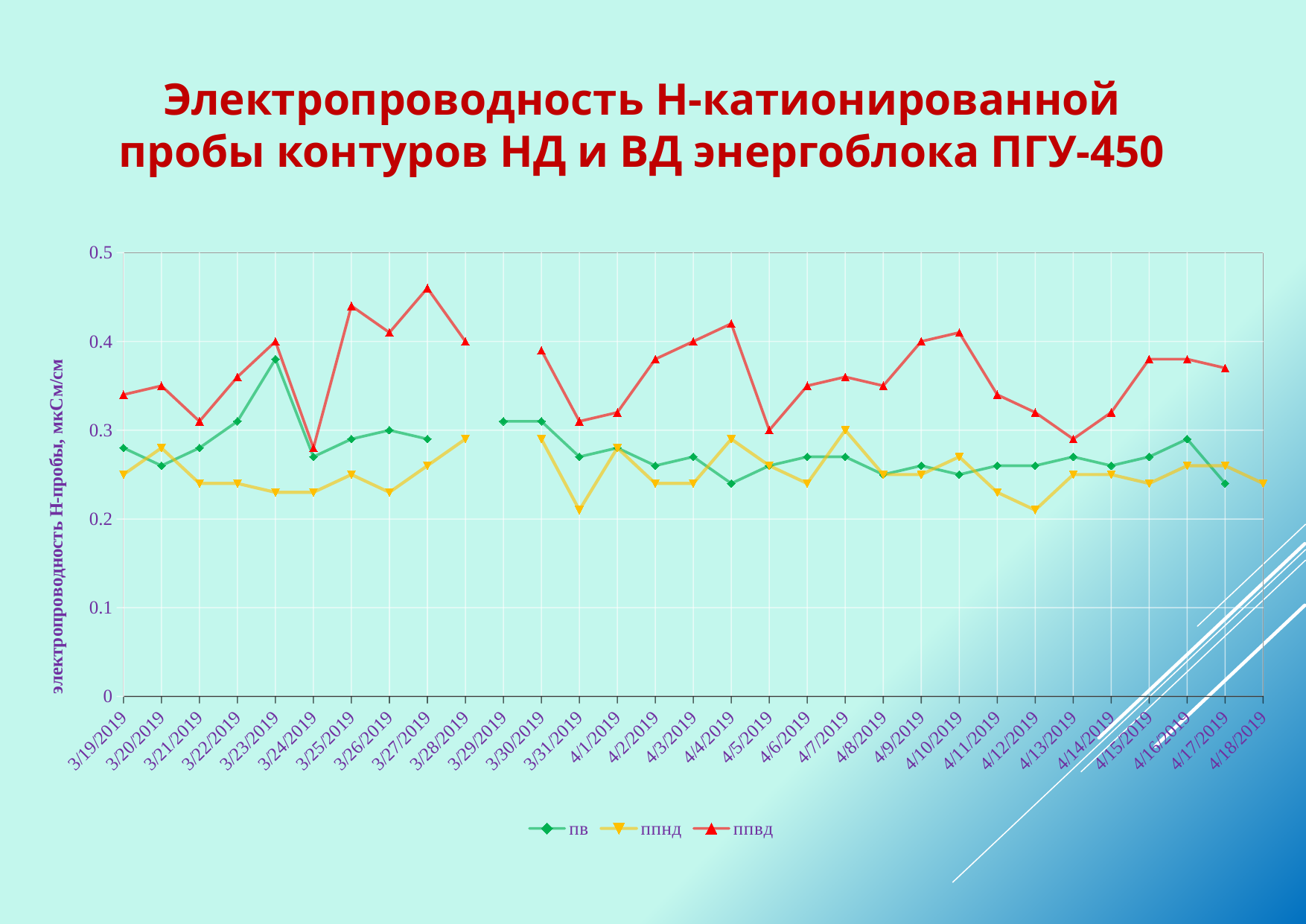
How many dates are shown on the x axis? 31 Is the value for ППНД on 3/31/2019 greater or less than 0.3? less What kind of chart is shown on the slide? line chart On 3/19/2019, which series has the larger value, ППВД or ПВ? ППВД Which series is plotted in red? ППВД Is the value for ППВД on 4/4/2019 greater or less than 0.4? greater Is the value for ПВ on 3/23/2019 greater or less than 0.3? greater How many series does the legend list? 3 On 4/7/2019, which series has the larger value, ППНД or ПВ? ППНД What is the y-axis title of the chart? электропроводность Н-пробы, мкСм/см On which date does the ППВД series reach its highest value? 3/27/2019